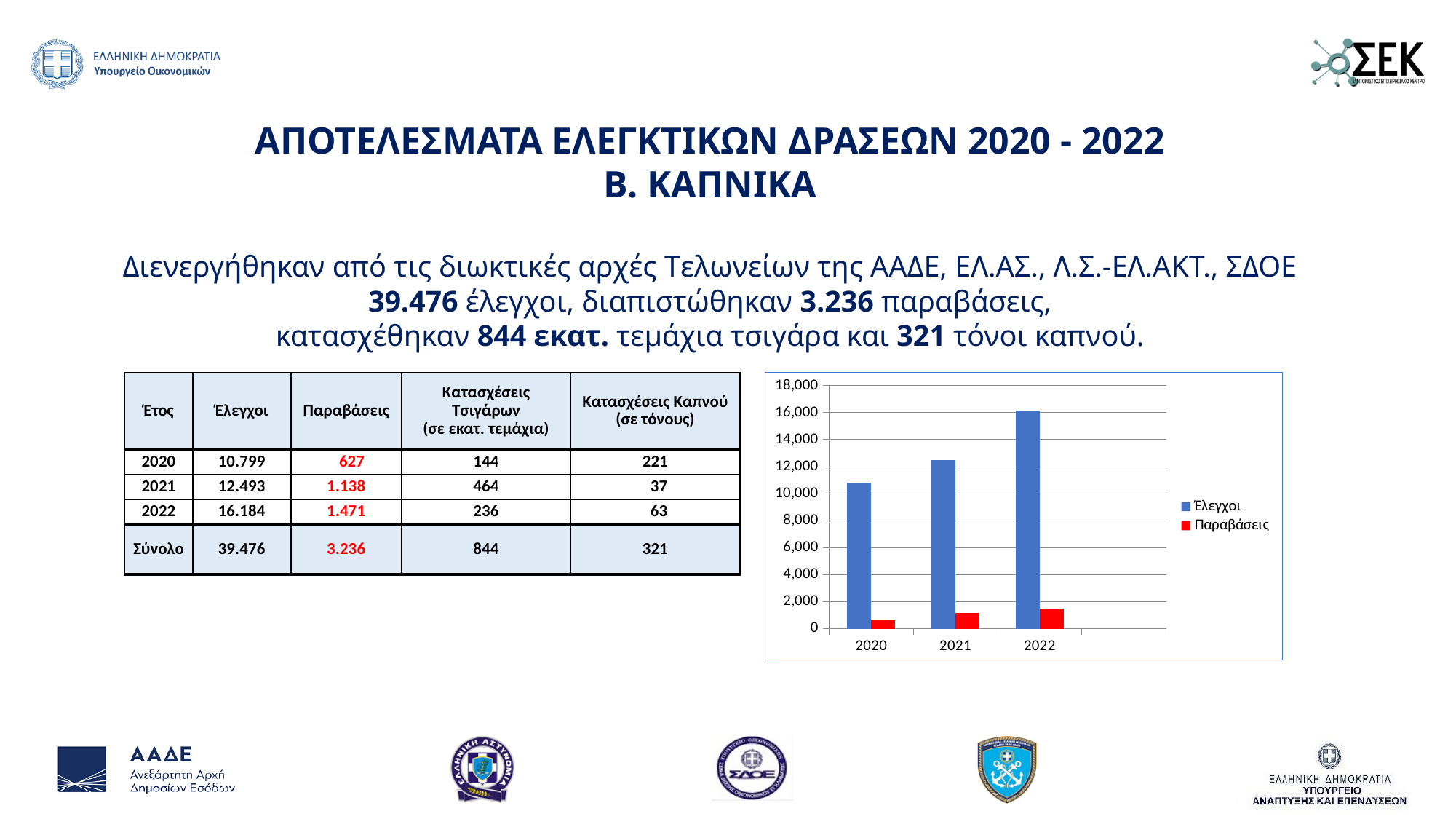
Do the Έλεγχοι values rise or fall from 2020 to 2022? rise Is the Έλεγχοι value for 2022 greater or less than 14,000? greater How many series does the chart's legend list? 2 Is the Παραβάσεις value for 2021 greater or less than 2,000? less For 2021, which is larger: Έλεγχοι or Παραβάσεις? Έλεγχοι In which year is the Έλεγχοι bar the lowest? 2020 In which year is the Έλεγχοι bar the highest? 2022 Is the Έλεγχοι value for 2020 greater or less than 12,000? less According to the slide, what is the Έλεγχοι value plotted for 2021? 12.493 Which colour represents Παραβάσεις in the chart's legend? red What kind of chart is shown on the slide? bar chart How many years are shown on the x axis of the chart? 3